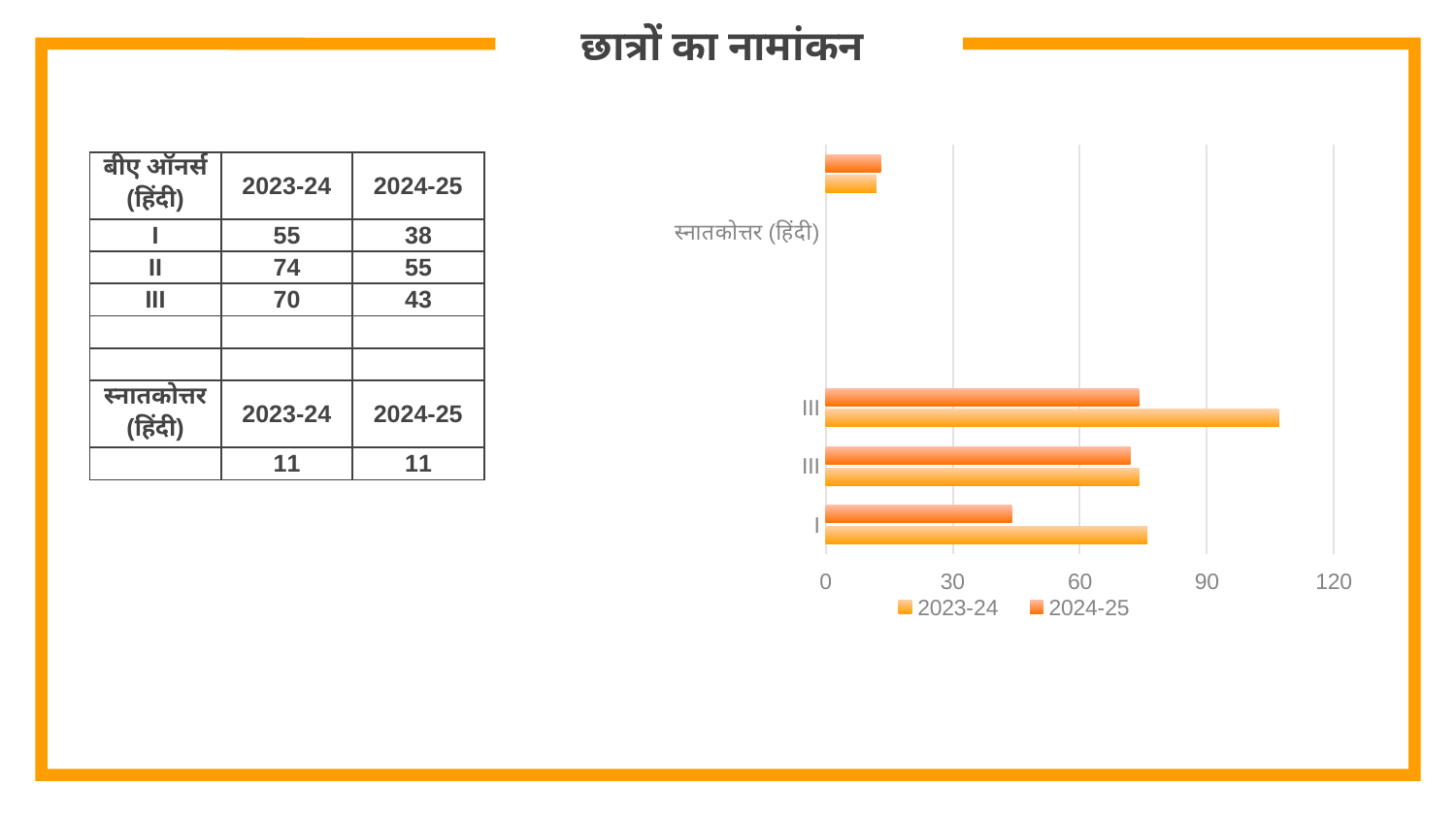
Is the 2023-24 value for category I greater or less than 60? greater Is the 2023-24 value for स्नातकोत्तर (हिंदी) greater or less than 30? less How many series does the chart legend list? 2 Is the 2024-25 value for category I greater or less than 30? greater What is the highest value shown on the chart's horizontal axis? 120 What kind of chart is shown on the slide? bar chart Which category has the longest 2023-24 bar on the chart? III For category I, which series has the larger value, 2023-24 or 2024-25? 2023-24 What are the two series named in the chart legend? 2023-24 and 2024-25